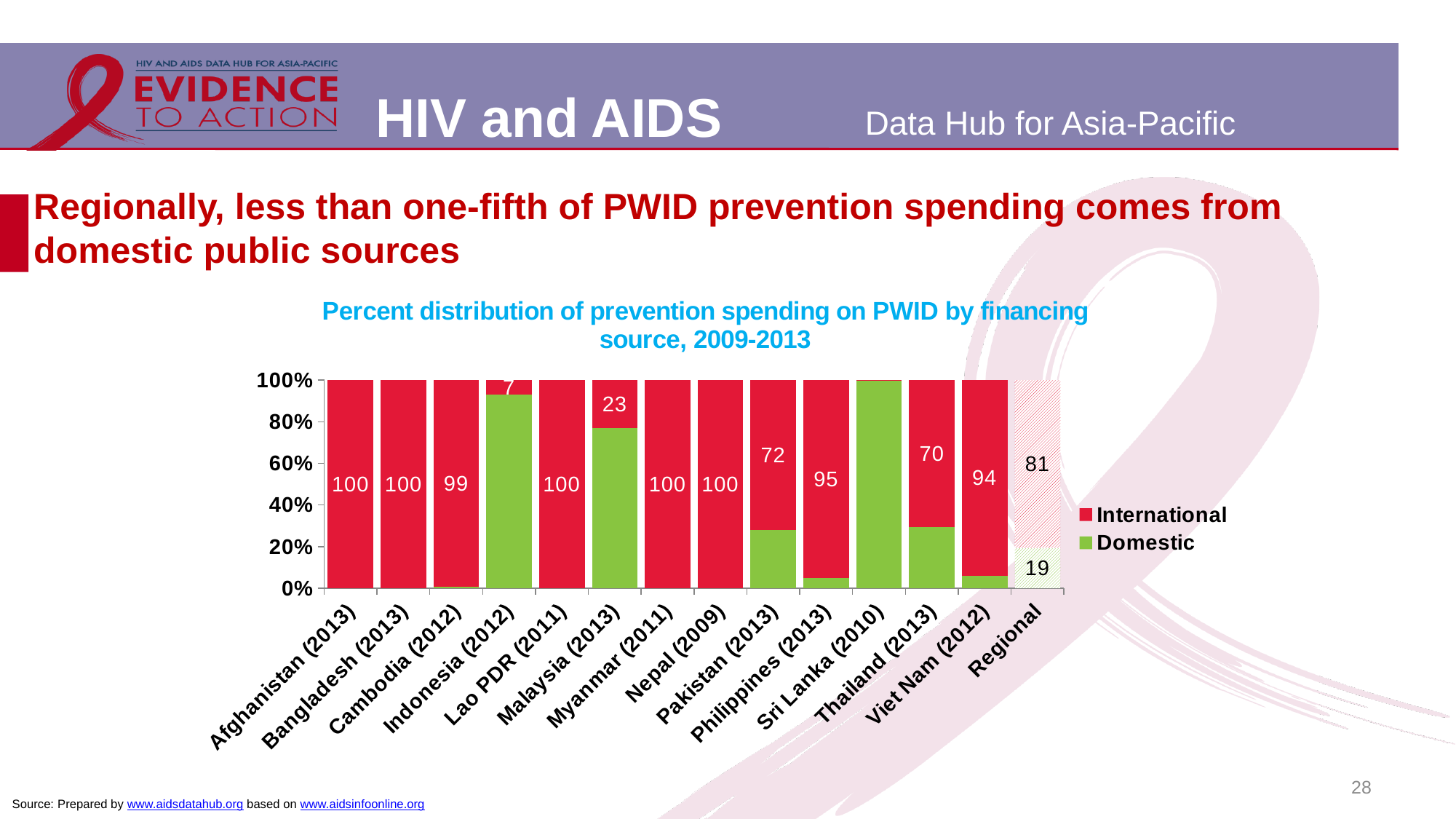
How many categories are shown along the x axis? 14 Which colour represents the Domestic series in the legend? Green What is the difference between the International and Domestic shares in the Regional bar? 62 Which has a larger International share, Malaysia (2013) or Pakistan (2013)? Pakistan (2013) How many series does the legend list? 2 What is the International share for Malaysia (2013)? 23 What is the Domestic share for the Regional bar? 19 What is the International share for Thailand (2013)? 70 Which category has the largest Domestic share? Sri Lanka (2010) Is the Domestic share for Indonesia (2012) greater or less than 80%? greater What type of chart is shown on the slide? Stacked bar chart What is the International share for Indonesia (2012)? 7